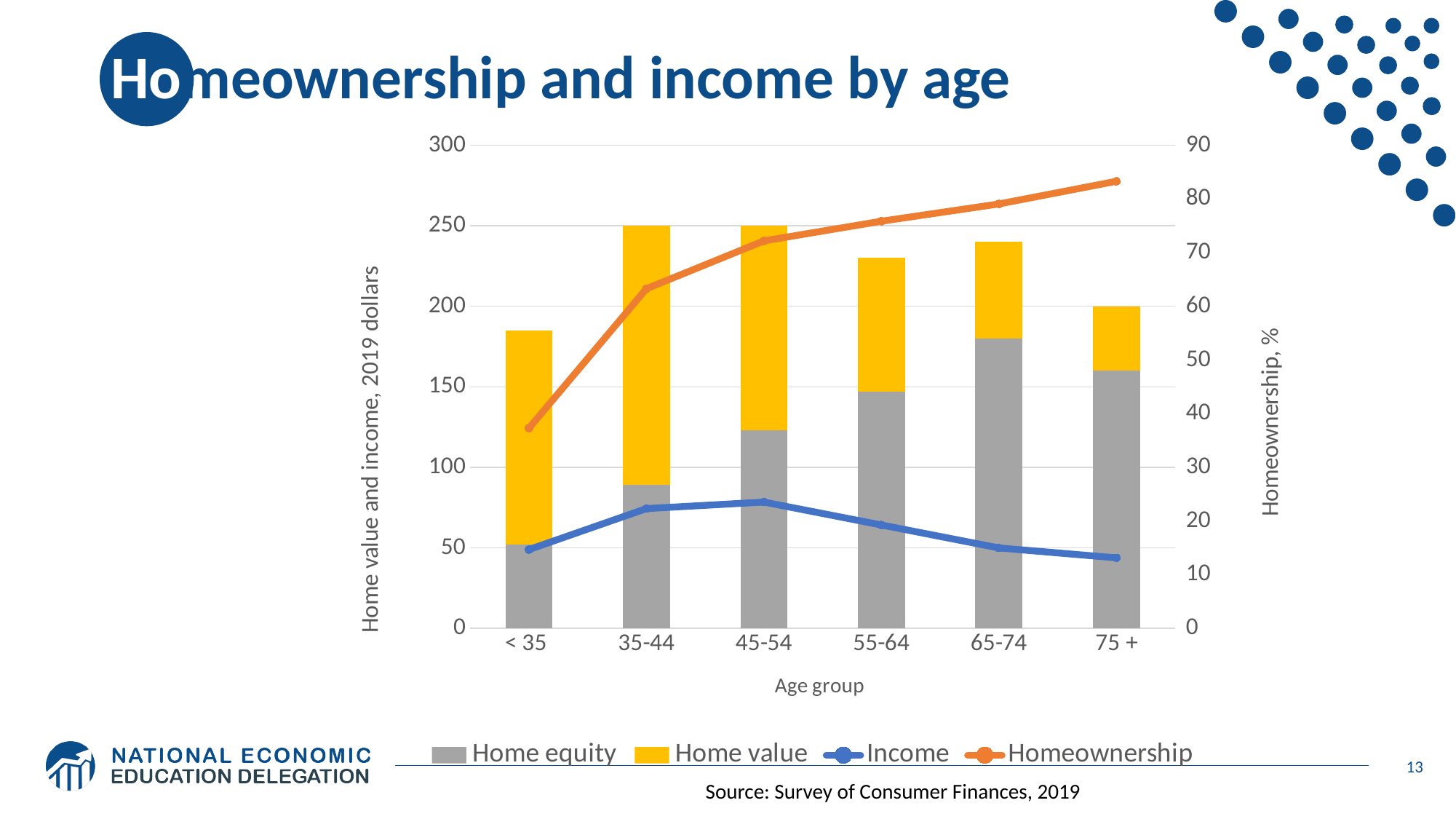
Does the Income line rise or fall from the 45-54 group to the 75 + group? Falls What is the title of the right-hand vertical axis? Homeownership, % What kind of chart is shown on the slide? A combination chart with stacked bars and lines Is the Homeownership value for the < 35 age group greater or less than 50? less Which age group has the highest Home equity bar? 65-74 How many series does the legend list? 4 What is the total height of the stacked bar for the 75 + age group on the left axis? 200 Which age group has the lowest Home equity bar? < 35 Which is larger, the Homeownership value for 35-44 or for 55-64? 55-64 Is the Home equity value for the 45-54 age group greater or less than 100? greater Does the Homeownership line rise or fall as age group increases? Rises How many age groups are shown on the x axis? 6